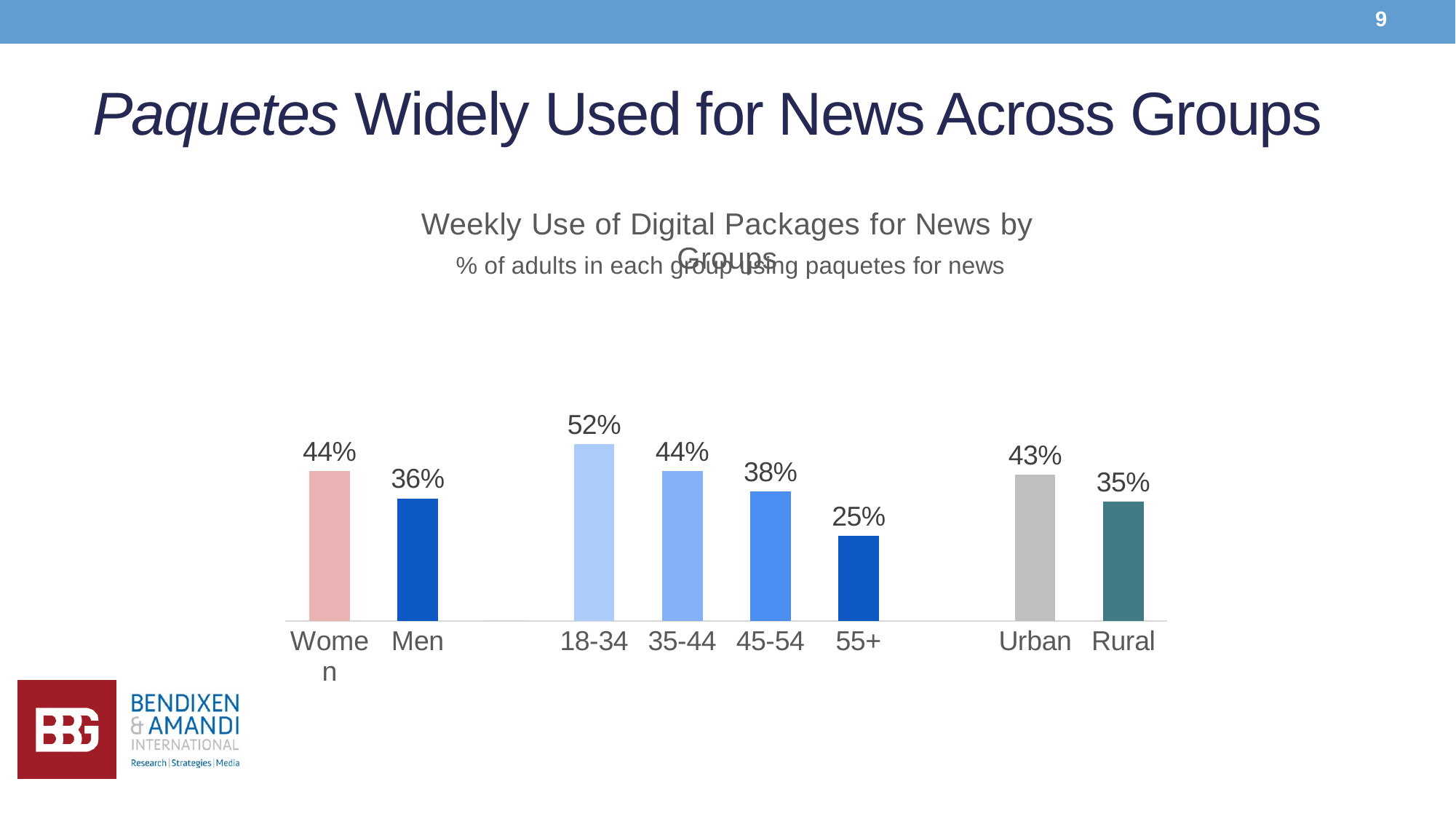
Which is larger, the value for Urban or the value for Rural? Urban What is the difference between the values for Women and Men? 8% How many groups are plotted in the chart? 8 What kind of chart is shown? Bar chart Do the values rise or fall across the age groups from 18-34 to 55+? Fall Which group has the highest value? 18-34 What is the value for Women? 44% What is the value for Rural? 35% What is the value for the 18-34 group? 52% What is the value for the 55+ group? 25% Which group has the lowest value? 55+ What is the difference between the values for 18-34 and 55+? 27%